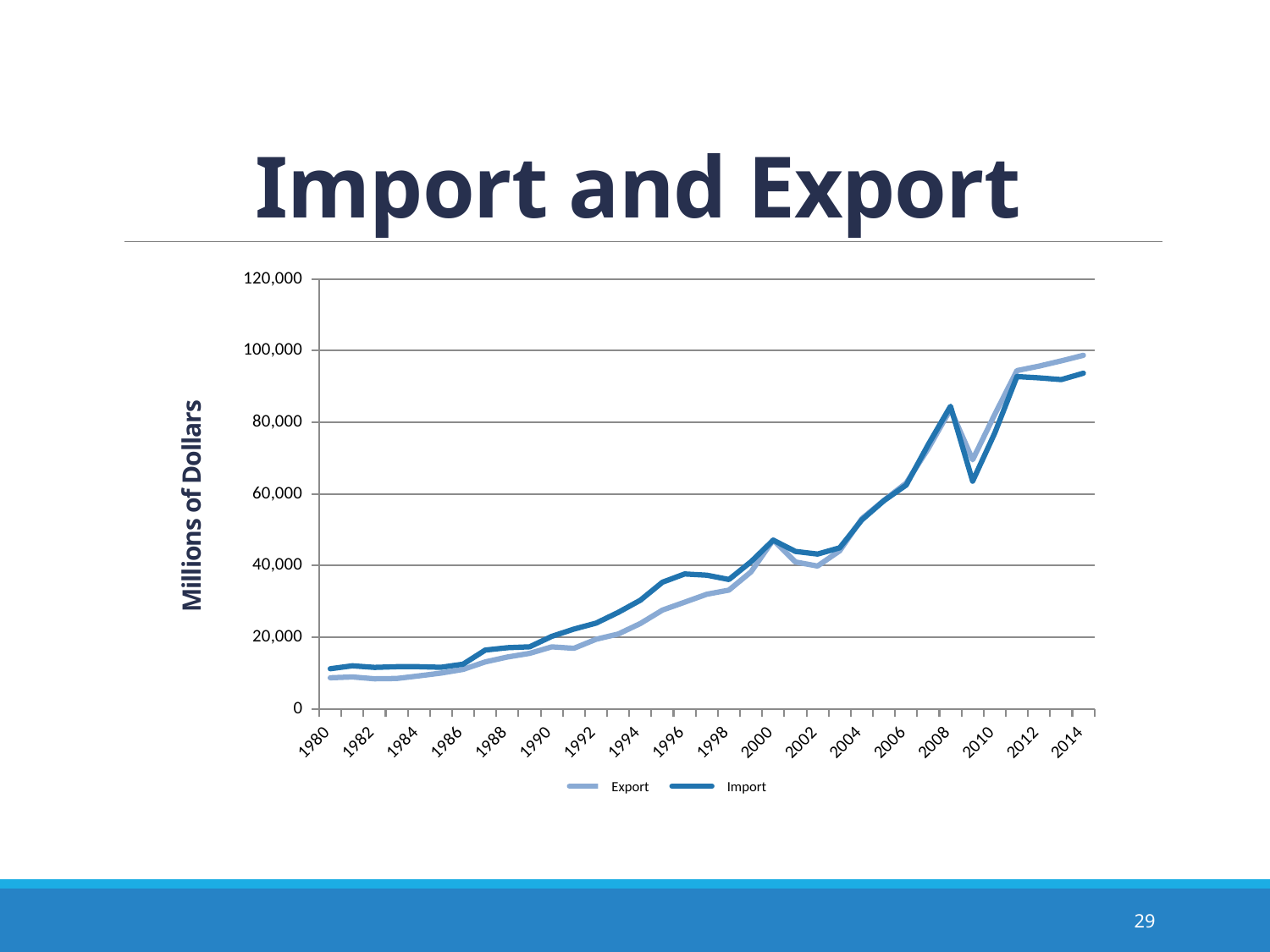
How many series does the legend list? 2 What is the label on the vertical axis? Millions of Dollars Is the Import value for 1980 greater or less than 20,000? less In 2014, which is larger, Export or Import? Export Do the Export values generally rise or fall from 1980 to 2014? Rise Is the Import value for 2008 greater or less than 80,000? greater Is the Import value for 1996 greater or less than 40,000? less In 1996, which is larger, Import or Export? Import What is the title of the chart? Import and Export In which year is the Export value highest? 2014 What kind of chart is shown on the slide? Line chart